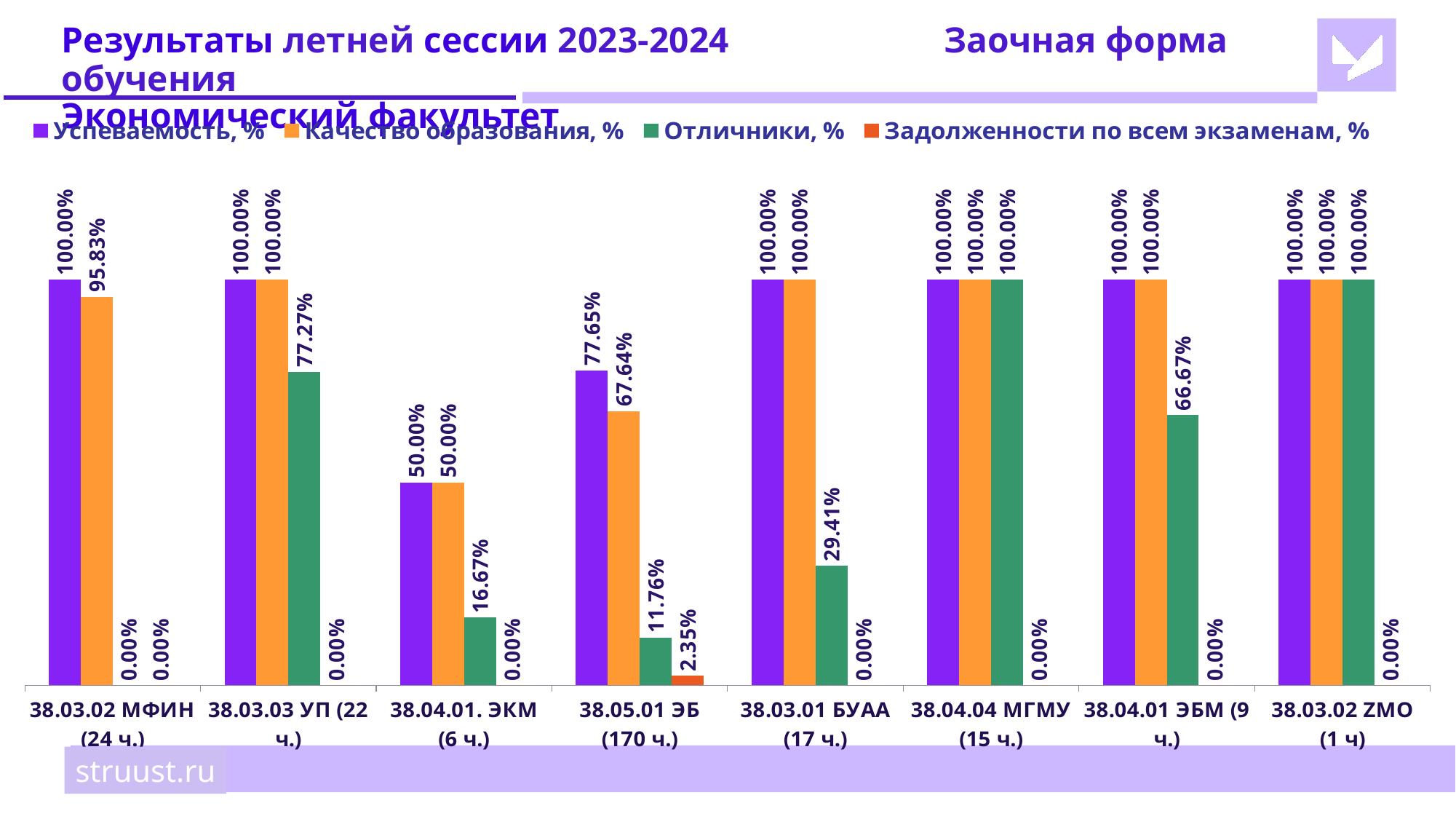
Which category has the lowest value of Отличники, %? 38.03.02 МФИН (24 ч.) What is the value of Задолженности по всем экзаменам, % for 38.05.01 ЭБ (170 ч.)? 2.35% What kind of chart is shown on the slide? Bar chart Which category has the lowest value of Успеваемость, %? 38.04.01. ЭКМ (6 ч.) Which series is shown in orange in the legend? Качество образования, % What is the value of Отличники, % for 38.03.03 УП (22 ч.)? 77.27% What is the value of Успеваемость, % for 38.05.01 ЭБ (170 ч.)? 77.65% What is the value of Качество образования, % for 38.03.02 МФИН (24 ч.)? 95.83% Which is larger for 38.03.01 БУАА (17 ч.): Отличники, % or Качество образования, %? Качество образования, % How many categories are shown on the x axis? 8 What is the difference between Успеваемость, % and Качество образования, % for 38.05.01 ЭБ (170 ч.)? 10.01% How many series does the legend list? 4